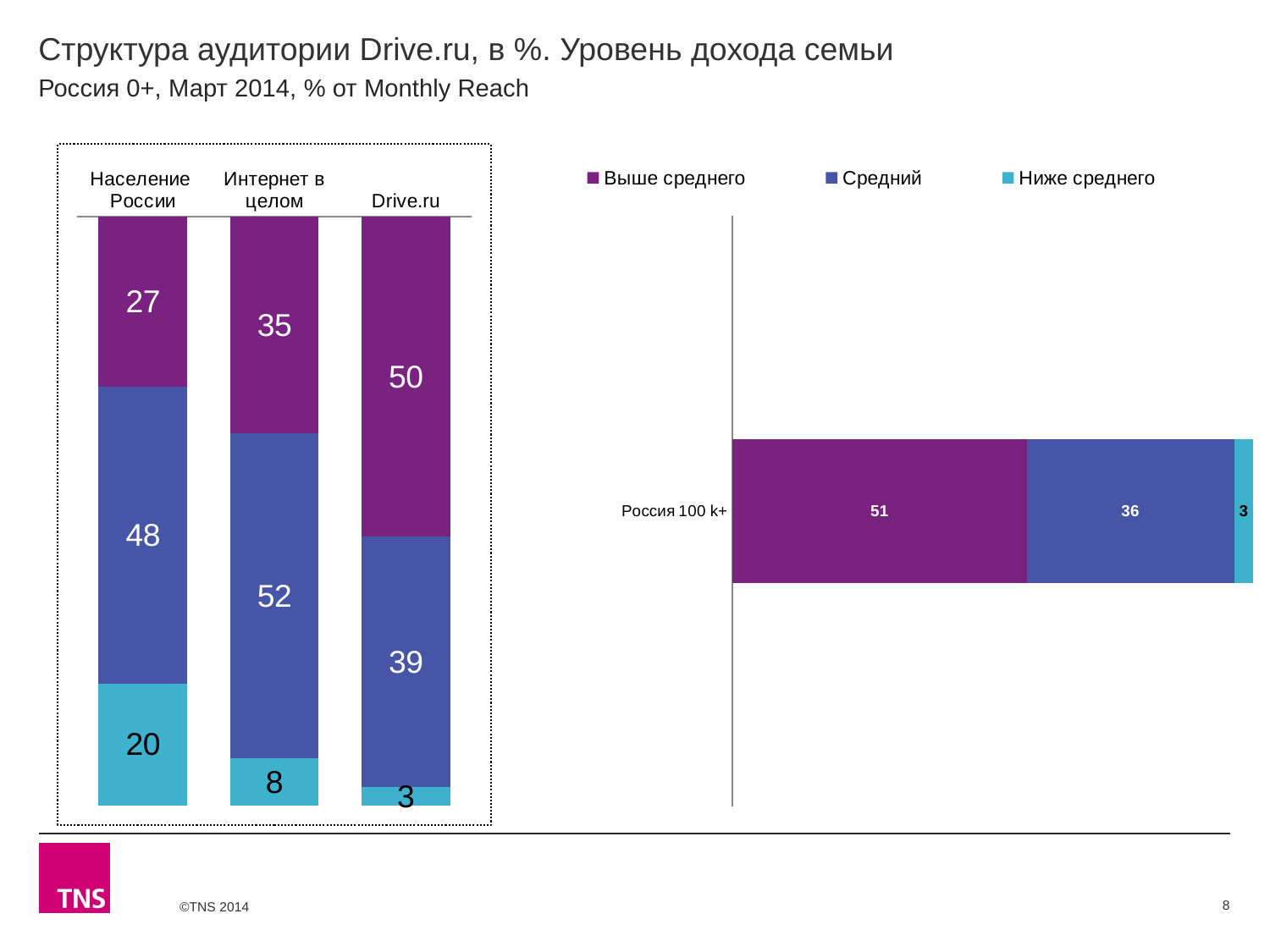
In the right chart, what is the total of the stacked bar for Россия 100 k+? 90 In the left chart, what is the difference between the 'Выше среднего' values for Drive.ru and Население России? 23 What type of chart is the right chart? Stacked bar chart In the left chart, what is the value of 'Средний' for Интернет в целом? 52 In the left chart, what is the value of 'Ниже среднего' for Население России? 20 In the left chart, is the 'Средний' value larger for Население России or for Drive.ru? Население России In the left chart, which category has the highest 'Выше среднего' value? Drive.ru How many series does the legend list? 3 How many categories are shown in the left chart? 3 In the right chart, what is the value of 'Средний' for Россия 100 k+? 36 In the left chart, which category has the lowest 'Ниже среднего' value? Drive.ru In the left chart, what is the value of 'Выше среднего' for Drive.ru? 50